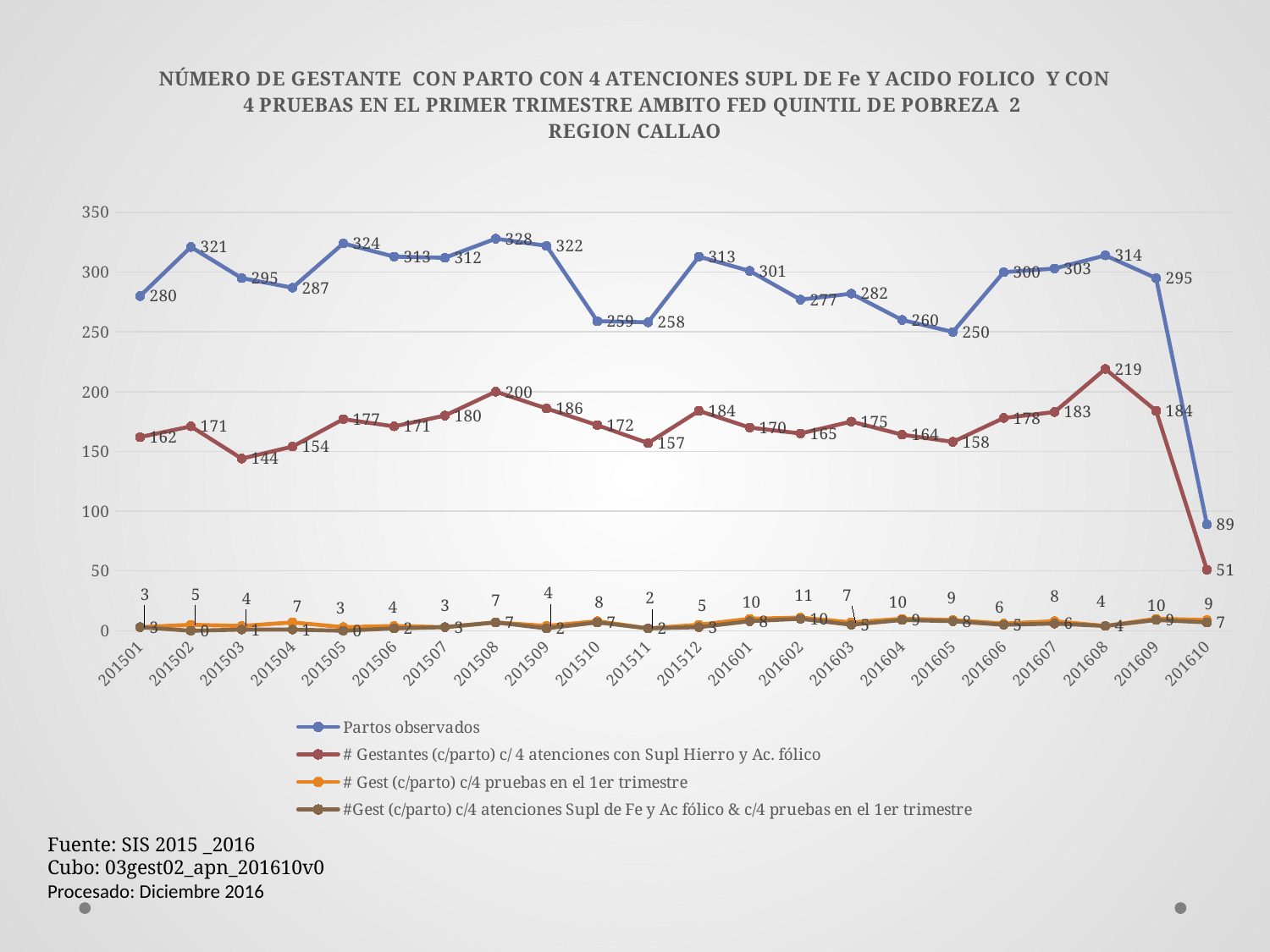
What is the value of # Gestantes (c/parto) c/ 4 atenciones con Supl Hierro y Ac. fólico for 201608? 219 How many time periods are plotted along the x axis? 22 In which period is Partos observados lowest? 201610 What type of chart is shown on the slide? Line chart What is the value of # Gest (c/parto) c/4 pruebas en el 1er trimestre for 201602? 11 How many series does the legend list? 4 What is the value of #Gest (c/parto) c/4 atenciones Supl de Fe y Ac fólico & c/4 pruebas en el 1er trimestre for 201610? 7 What is the value of Partos observados for 201508? 328 What is the difference between Partos observados in 201609 and 201610? 206 In which period is # Gestantes (c/parto) c/ 4 atenciones con Supl Hierro y Ac. fólico highest? 201608 Is the value of Partos observados for 201605 greater or less than 300? less Which is larger, Partos observados in 201502 or in 201505? 201505